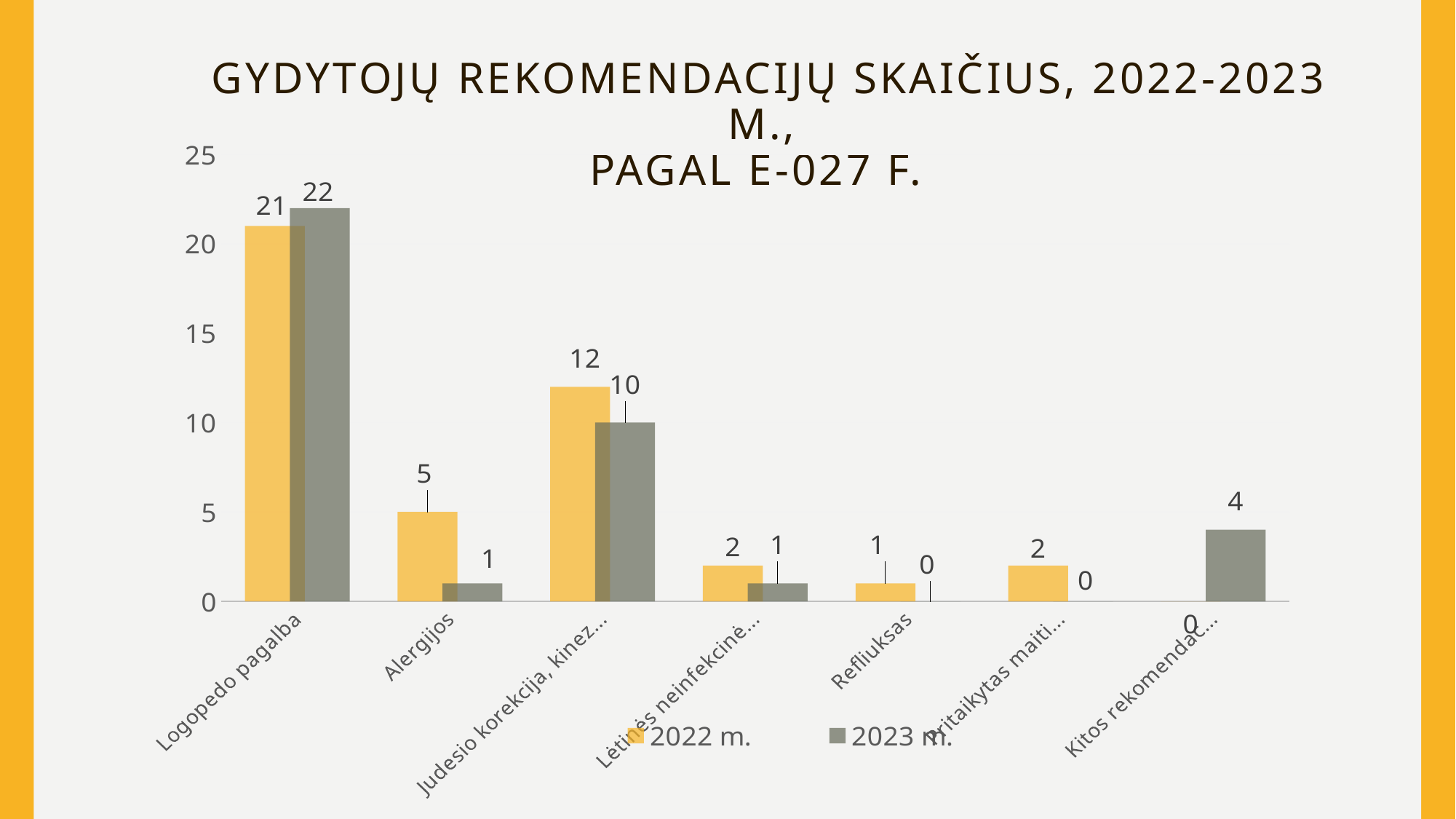
What kind of chart is shown on the slide? bar chart What is the value for Logopedo pagalba in 2023 m.? 22 How many categories are shown on the x axis? 7 How many series does the legend list? 2 What is the value for Alergijos in 2023 m.? 1 Which category has the highest value in the 2023 m. series? Logopedo pagalba Which series is shown in yellow in the legend? 2022 m. Which is larger for Logopedo pagalba: the 2022 m. value or the 2023 m. value? 2023 m. What is the value for Alergijos in 2022 m.? 5 What is the value for Logopedo pagalba in 2022 m.? 21 What is the difference between the 2022 m. and 2023 m. values for Alergijos? 4 What is the value for Refliuksas in 2023 m.? 0